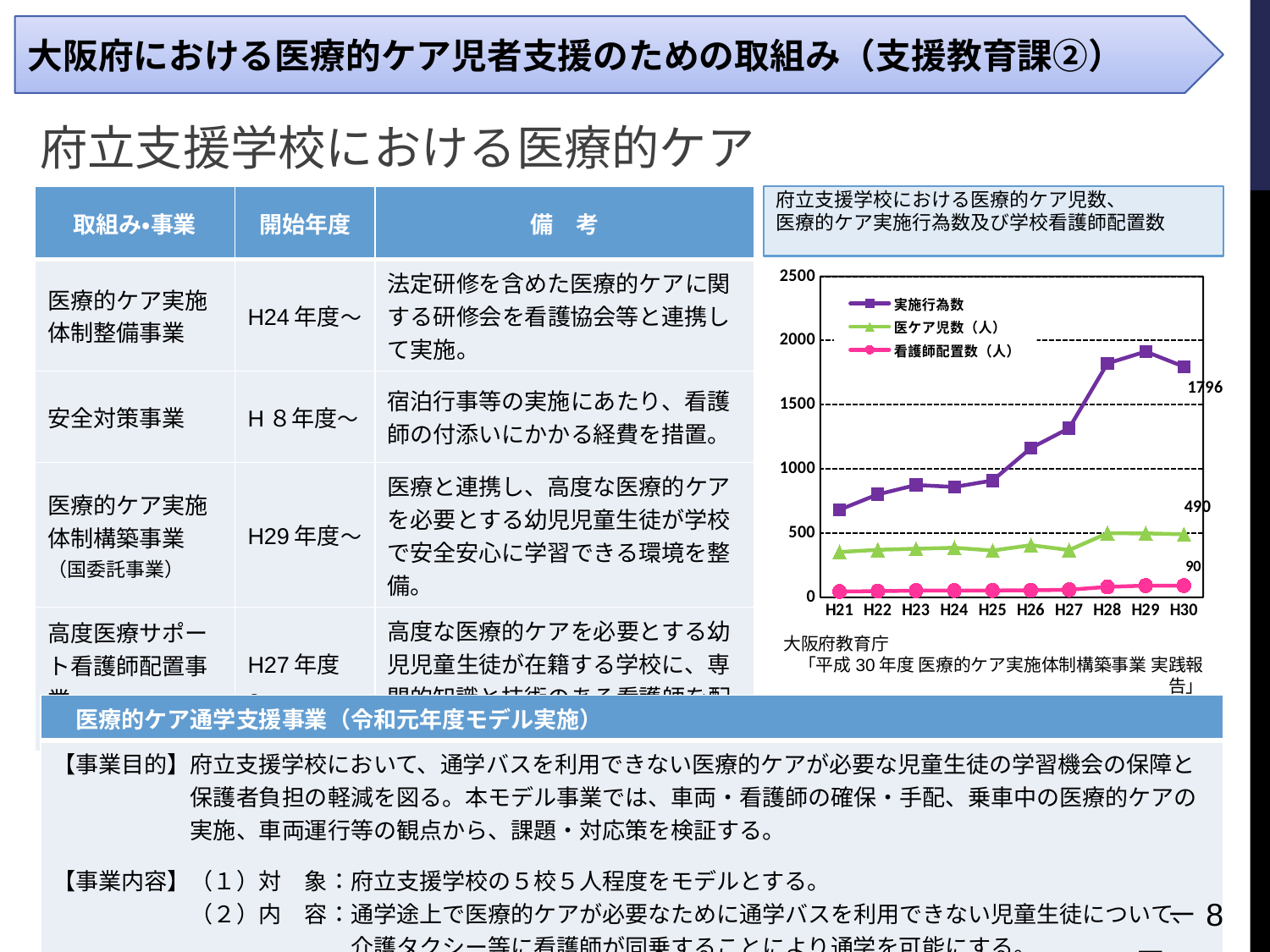
What is the value of 実施行為数 in H30? 1796 How many series does the chart legend list? 3 Is the value of 実施行為数 in H28 greater or less than 1500? greater Is the value of 実施行為数 in H21 greater or less than 1000? less What is the value of 看護師配置数（人） in H30? 90 How many years are plotted along the x axis of the chart? 10 What is the value of 医ケア児数（人） in H30? 490 What kind of chart is shown on the slide? line chart Which series has the highest value in H30? 実施行為数 What is the difference between 実施行為数 and 医ケア児数（人） in H30? 1306 Does 実施行為数 generally rise or fall from H21 to H30? rise In which year is 実施行為数 at its lowest? H21